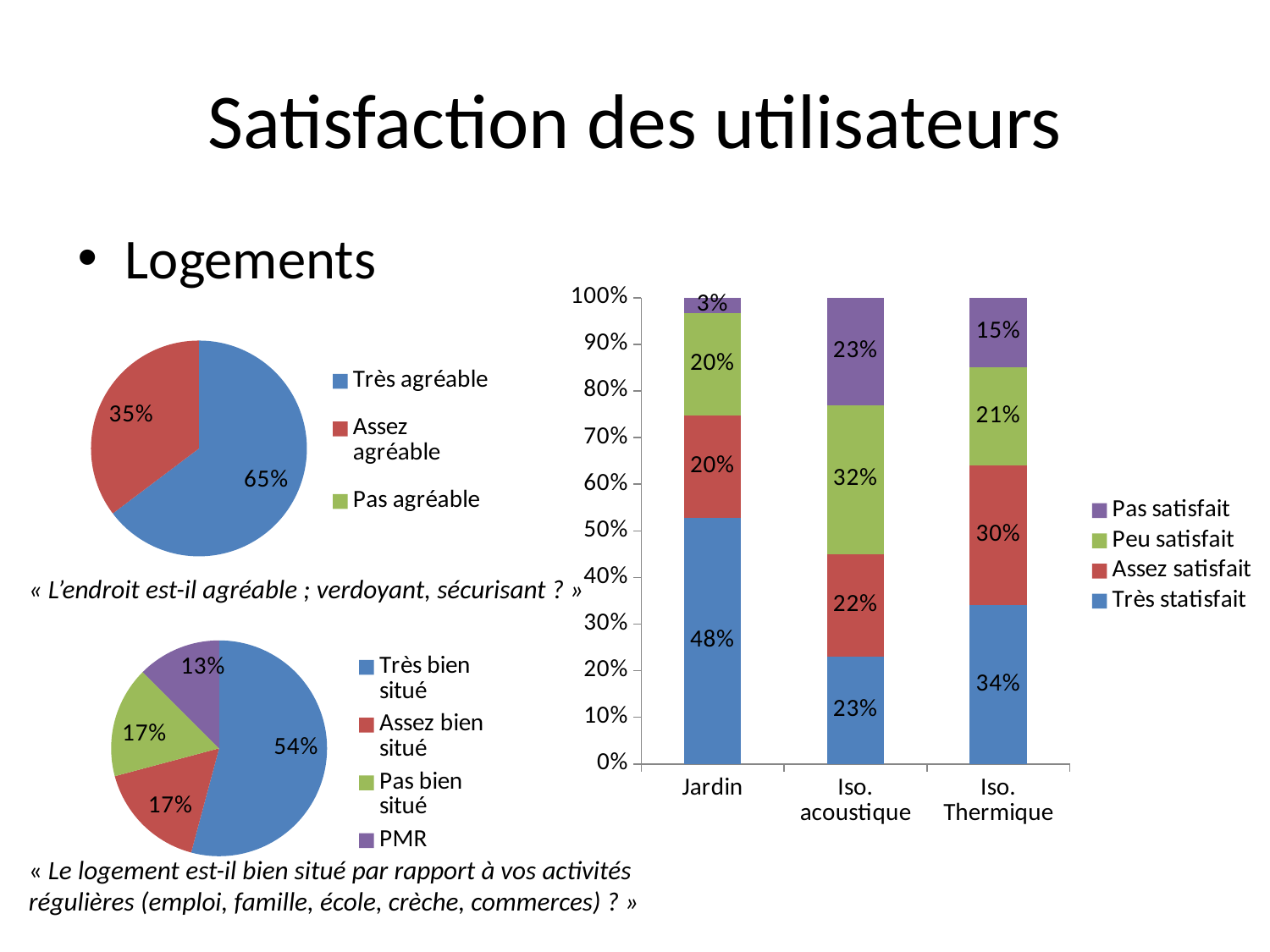
In the bottom-left pie chart, what percentage is labelled for 'Très bien situé'? 54% In the stacked bar chart on the right, how many categories are shown on the x axis? 3 In the stacked bar chart on the right, what is the 'Très statisfait' value for 'Iso. Thermique'? 34% In the bottom-left pie chart, what percentage is labelled for 'PMR'? 13% In the top-left pie chart, what percentage is labelled for 'Très agréable'? 65% In the top-left pie chart, what percentage is labelled for 'Assez agréable'? 35% In the bottom-left pie chart, how many entries does the legend list? 4 In the stacked bar chart on the right, what is the 'Peu satisfait' value for 'Iso. acoustique'? 32% In the stacked bar chart on the right, which category has the highest 'Très statisfait' value? Jardin In the bottom-left pie chart, which category has the largest share? Très bien situé What kind of chart is the chart on the right of the slide? Stacked bar chart In the stacked bar chart on the right, what is the difference between the 'Pas satisfait' values for 'Iso. acoustique' and 'Iso. Thermique'? 8%